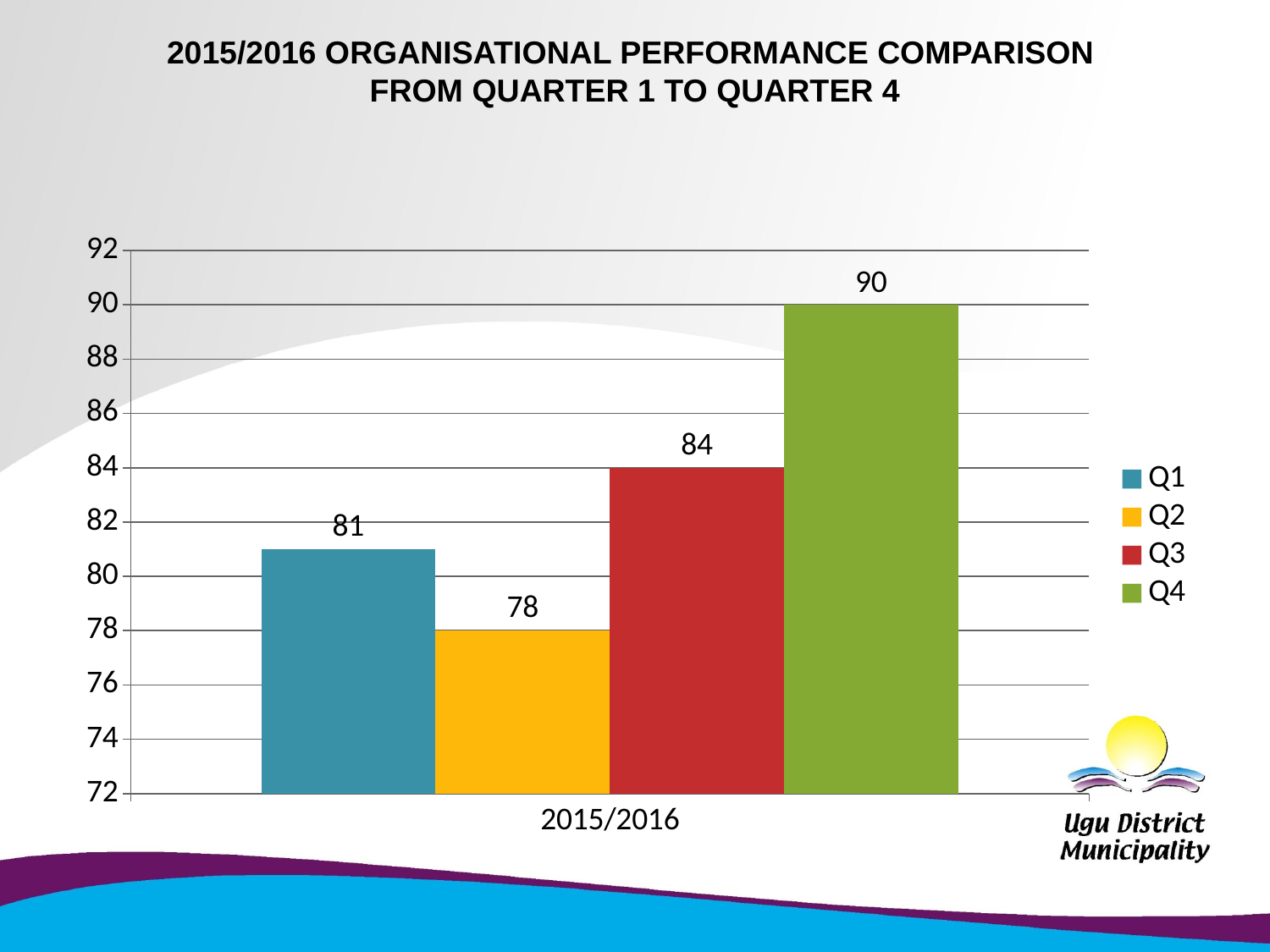
Which quarter has the highest value? Q4 What is the category label shown on the x axis? 2015/2016 Which is larger, the value for Q1 or the value for Q3? Q3 Which quarter has the lowest value? Q2 What is the difference between the Q3 and Q2 values? 6 What is the value for Q1? 81 What is the value for Q2? 78 How many series does the legend list? 4 What is the value for Q4? 90 What is the value for Q3? 84 What is the difference between the Q4 and Q1 values? 9 What kind of chart is shown on the slide? Bar chart